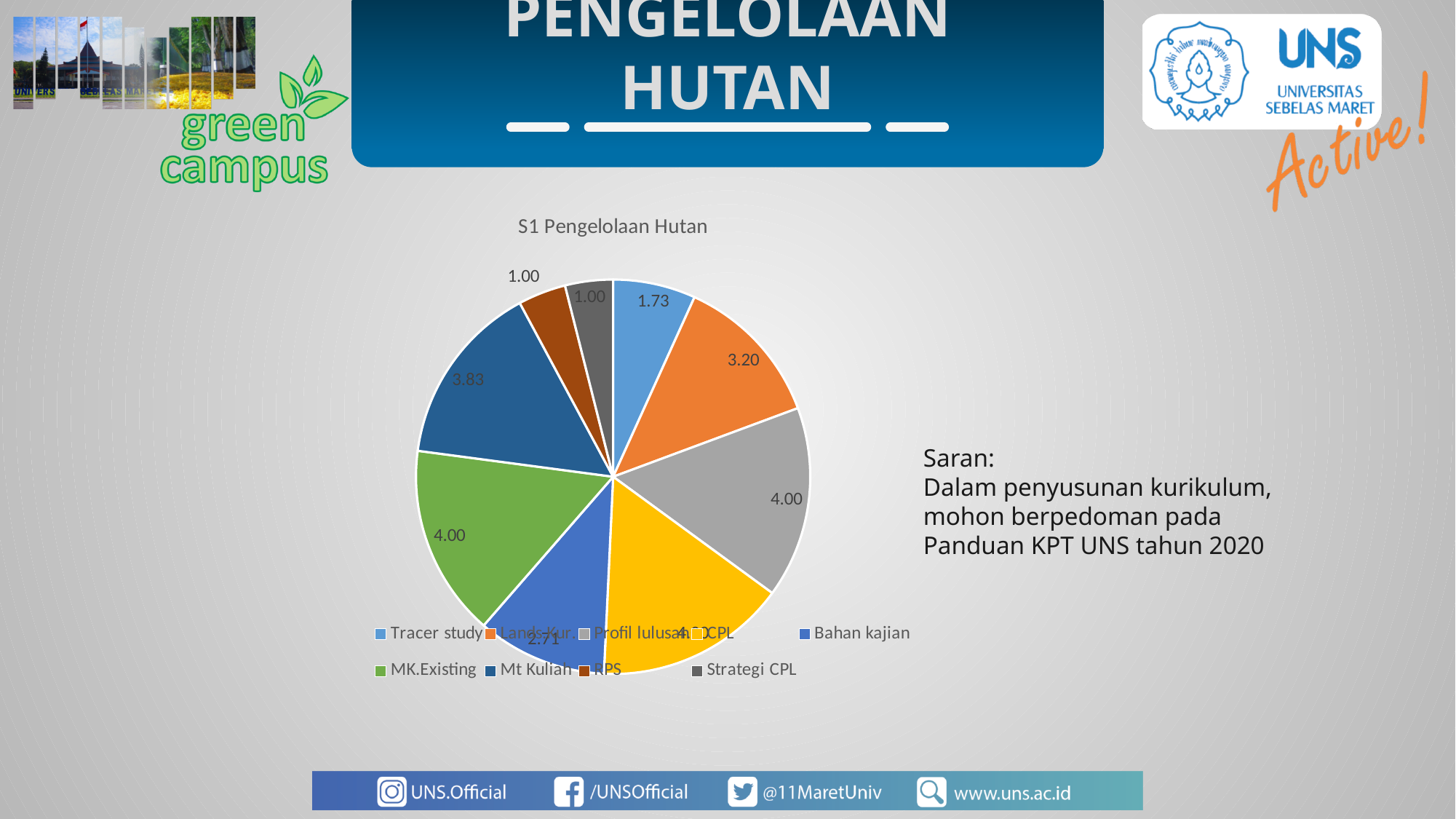
What is the value for MK.Existing? 4.00 What is the title of the chart? S1 Pengelolaan Hutan What is the value for Tracer study? 1.73 What is the difference between the values for Profil lulusan and Tracer study? 2.27 What is the value for Mt Kuliah? 3.83 What is the value for Lands Kur? 3.20 Which colour represents CPL in the pie chart? yellow Which is larger, Lands Kur or Tracer study? Lands Kur What type of chart is shown on the slide? pie chart How many categories does the pie chart have? 9 What is the value for RPS? 1.00 What is the value for Bahan kajian? 2.71